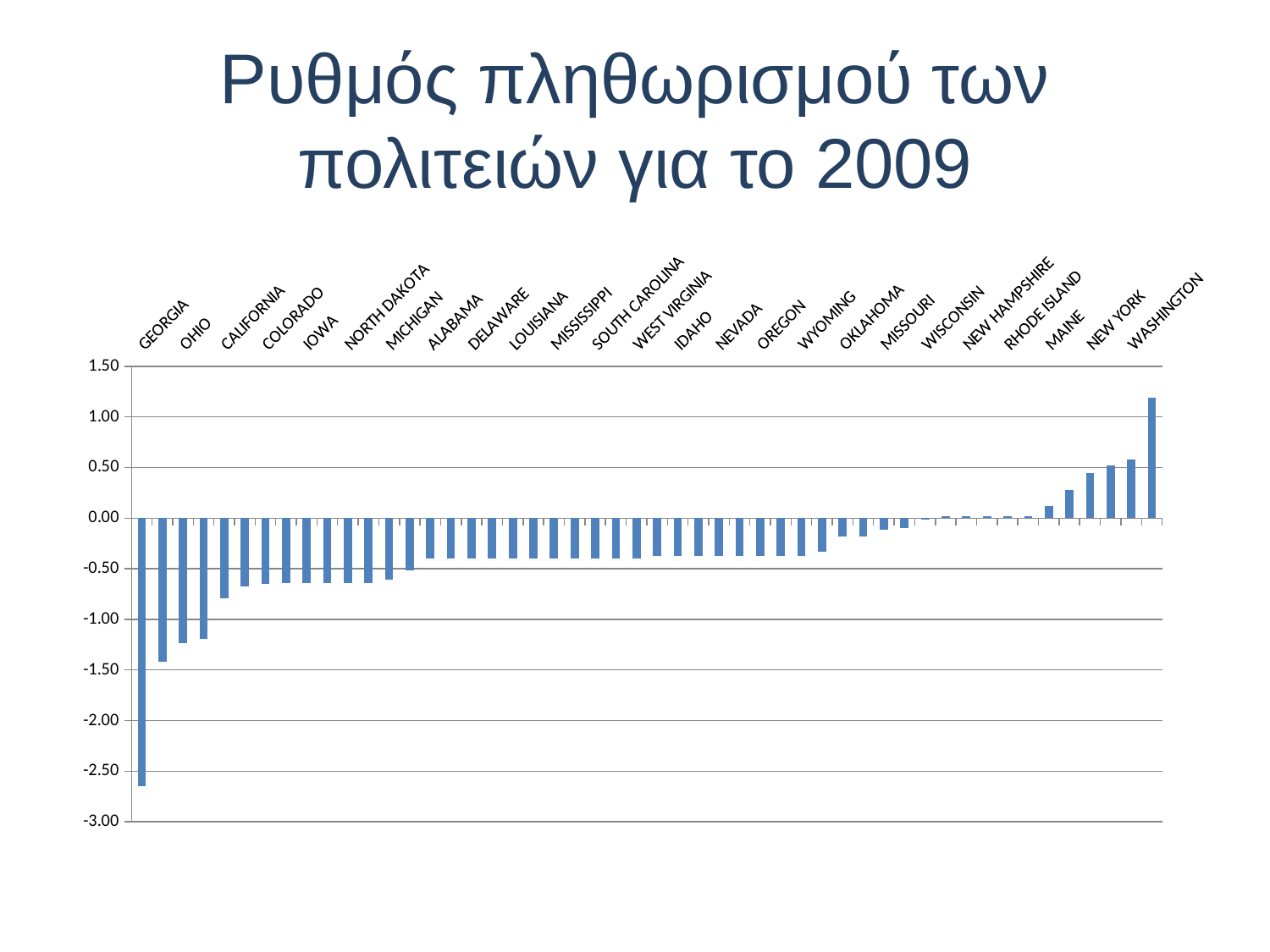
Which is larger, the value for Georgia or the value for Washington? Washington Is the value for Maine greater or less than 0.00? greater Is the value for Wyoming greater or less than 0.00? less What is the title of the chart on the slide? Ρυθμός πληθωρισμού των πολιτειών για το 2009 What kind of chart is shown on the slide? bar chart Which state has the lowest inflation rate in the chart? Georgia Is the value for Ohio greater or less than -1.00? less Do the values generally rise or fall moving from left to right along the x axis? rise